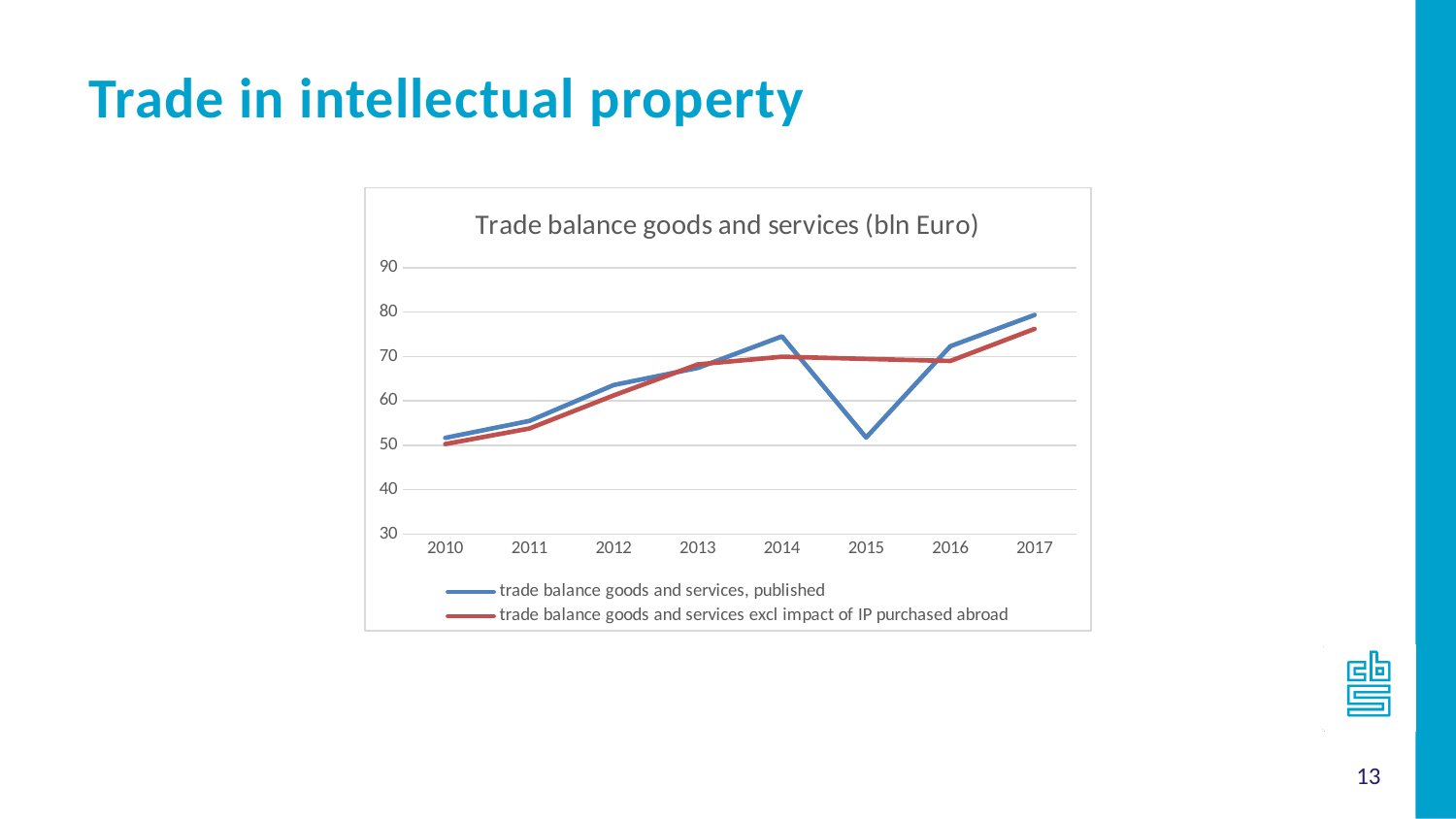
In which year is the 'trade balance goods and services excl impact of IP purchased abroad' series lowest? 2010 What kind of chart is shown on the slide? line chart In 2014, which series has the larger value: 'published' or 'excl impact of IP purchased abroad'? published What is the title of the chart? Trade balance goods and services (bln Euro) Does the 'trade balance goods and services excl impact of IP purchased abroad' series rise or fall from 2010 to 2014? rise How many years are plotted along the x axis? 8 In which year is the 'trade balance goods and services excl impact of IP purchased abroad' series highest? 2017 Which colour is the line for 'trade balance goods and services, published'? blue In which year is the 'trade balance goods and services, published' series highest? 2017 How many series does the legend list? 2 In 2015, which series has the larger value: 'published' or 'excl impact of IP purchased abroad'? excl impact of IP purchased abroad Is the value for 'trade balance goods and services, published' in 2015 greater or less than 60? less